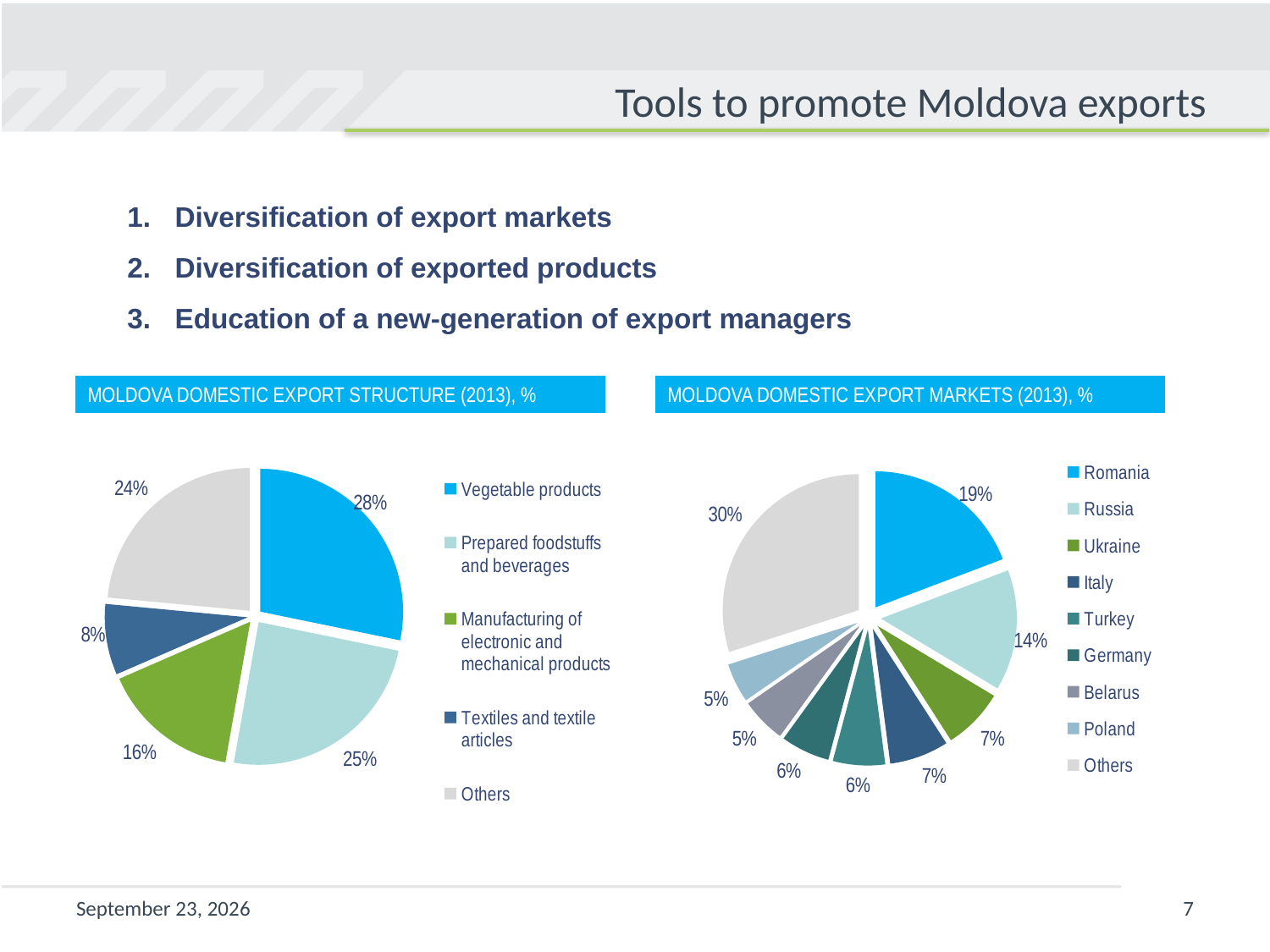
In the MOLDOVA DOMESTIC EXPORT STRUCTURE (2013) chart, what share do Vegetable products have? 28% What type of chart is used for MOLDOVA DOMESTIC EXPORT MARKETS (2013)? Pie chart In the MOLDOVA DOMESTIC EXPORT MARKETS (2013) chart, how many categories does the legend list? 9 In the MOLDOVA DOMESTIC EXPORT MARKETS (2013) chart, what share does Romania have? 19% In the MOLDOVA DOMESTIC EXPORT STRUCTURE (2013) chart, how many categories does the legend list? 5 In the MOLDOVA DOMESTIC EXPORT STRUCTURE (2013) chart, which category has the largest slice? Vegetable products In the MOLDOVA DOMESTIC EXPORT STRUCTURE (2013) chart, what is the difference between the shares of Vegetable products and Prepared foodstuffs and beverages? 3% In the MOLDOVA DOMESTIC EXPORT STRUCTURE (2013) chart, what share do Textiles and textile articles have? 8% In the MOLDOVA DOMESTIC EXPORT MARKETS (2013) chart, which slice is the largest? Others In the MOLDOVA DOMESTIC EXPORT MARKETS (2013) chart, which is larger, Romania or Russia? Romania In the MOLDOVA DOMESTIC EXPORT MARKETS (2013) chart, what share does Russia have? 14% In the MOLDOVA DOMESTIC EXPORT STRUCTURE (2013) chart, which category has the smallest slice? Textiles and textile articles